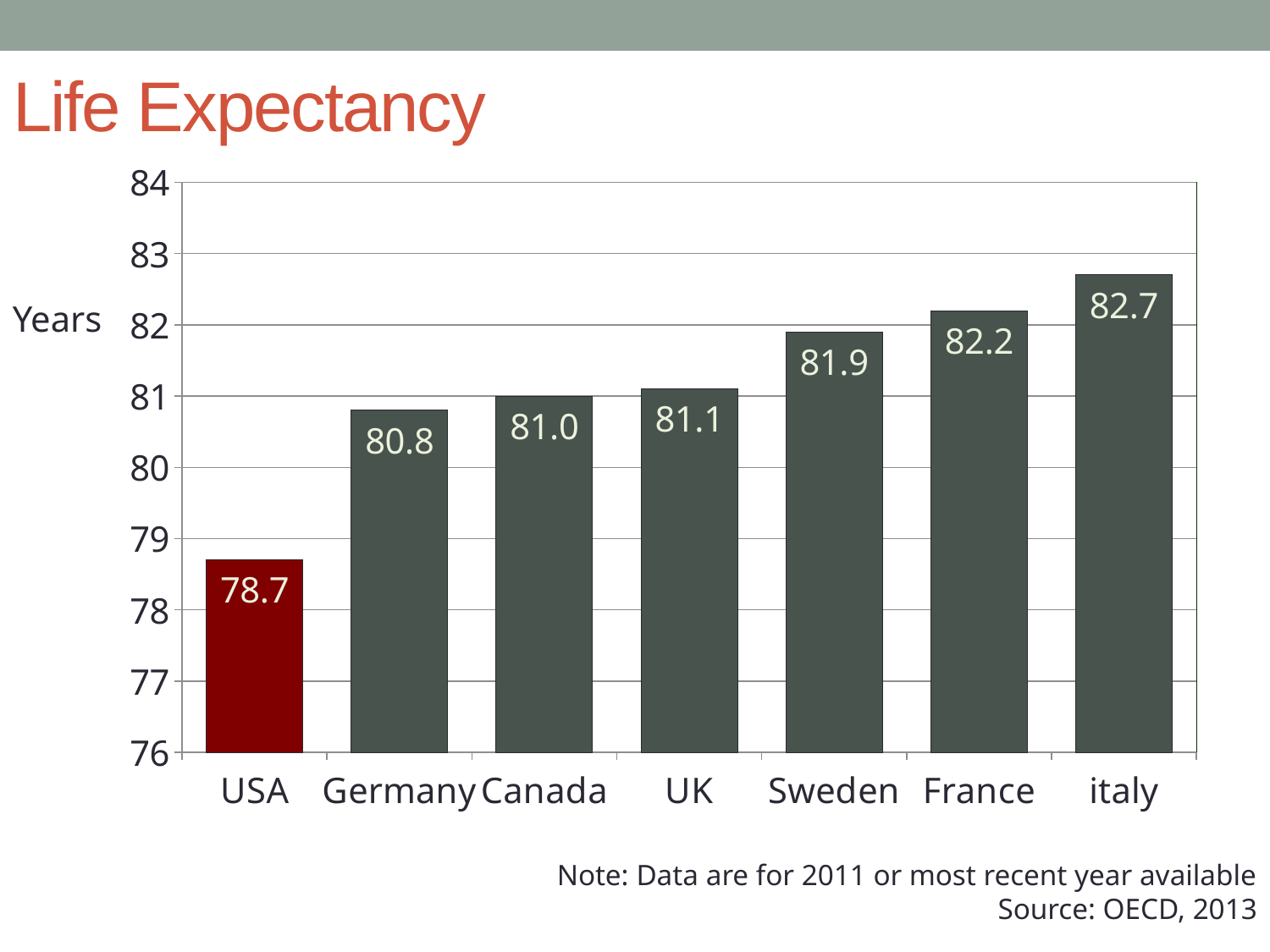
What is the difference in life expectancy between italy and the USA? 4.0 Which country has the lowest life expectancy on the chart? USA Which country has the highest life expectancy on the chart? italy Which bar is coloured differently from the others? USA Do the life expectancy values rise or fall from left to right across the chart? rise What is the life expectancy value shown for Sweden? 81.9 What is the difference in life expectancy between France and Germany? 1.4 What kind of chart is shown on the slide? bar chart How many countries are shown on the chart? 7 What is the life expectancy value shown for the USA? 78.7 What is the life expectancy value shown for Germany? 80.8 Which has a higher life expectancy, Canada or Sweden? Sweden